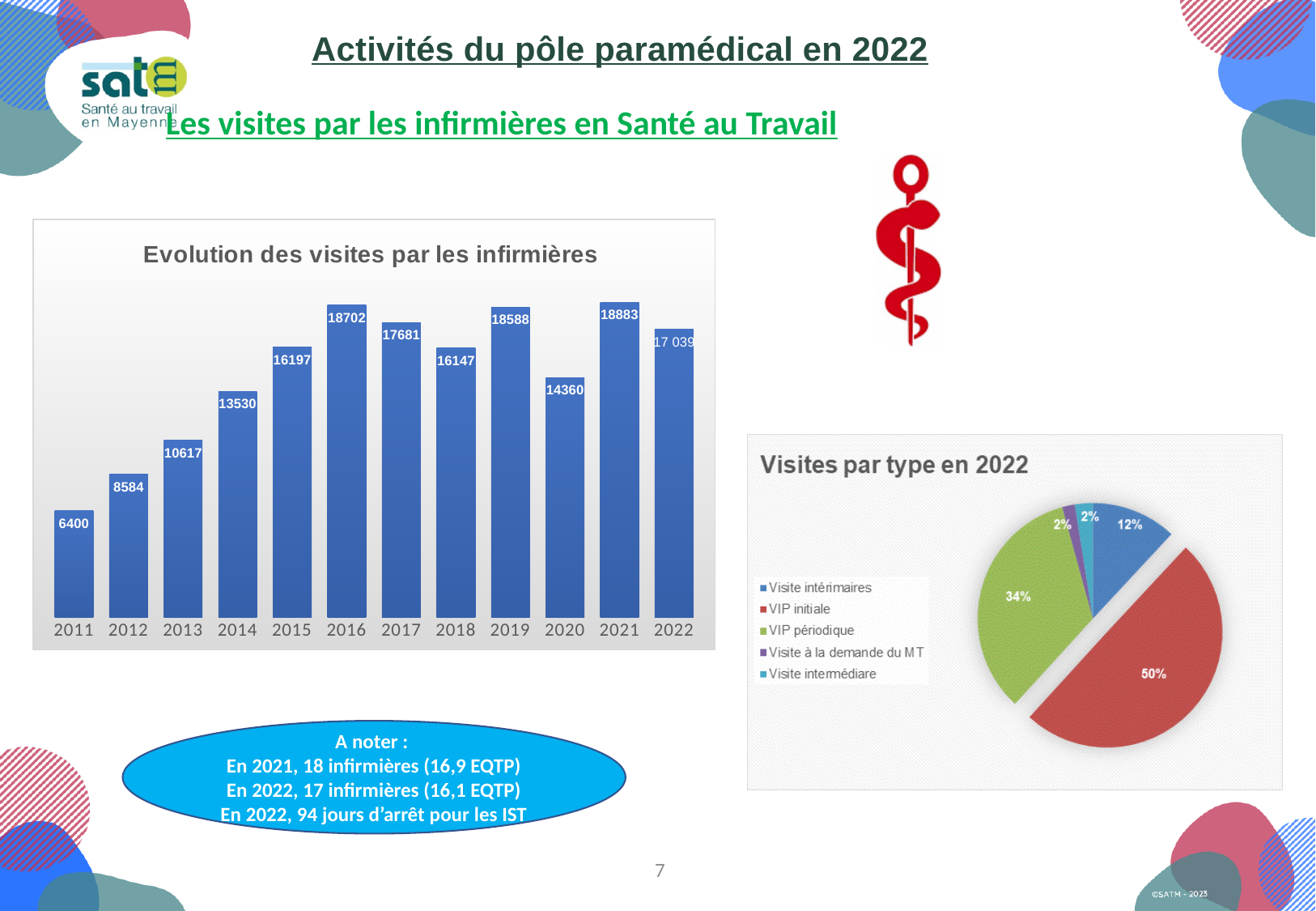
In the chart 'Evolution des visites par les infirmières', what is the value for 2016? 18702 In the chart 'Evolution des visites par les infirmières', do the values rise or fall from 2011 to 2016? rise In the chart 'Evolution des visites par les infirmières', what is the difference between the values for 2021 and 2020? 4523 In the chart 'Evolution des visites par les infirmières', which is larger, the value for 2017 or the value for 2018? 2017 In the chart 'Evolution des visites par les infirmières', what is the value for 2022? 17 039 How many years are shown in the chart 'Evolution des visites par les infirmières'? 12 In the chart 'Evolution des visites par les infirmières', which year has the lowest value? 2011 How many categories does the legend of the pie chart 'Visites par type en 2022' list? 5 In the chart 'Evolution des visites par les infirmières', which year has the highest value? 2021 In the pie chart 'Visites par type en 2022', what share is 'VIP périodique'? 34% What kind of chart is 'Evolution des visites par les infirmières'? bar chart In the pie chart 'Visites par type en 2022', what share is 'VIP initiale'? 50%